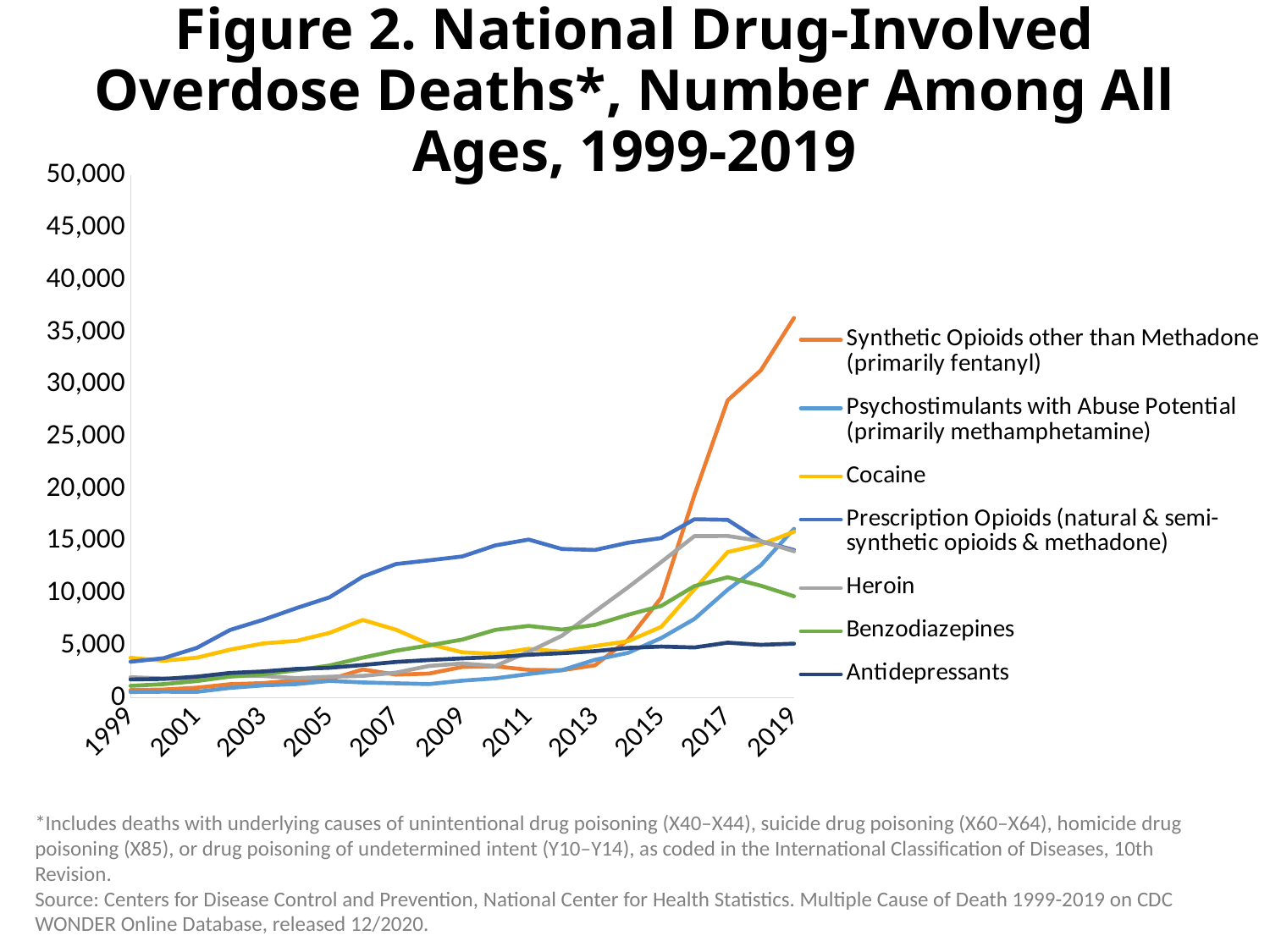
Is the value for Antidepressants in 2019 greater or less than 10,000? less In 2019, which is larger: Synthetic Opioids other than Methadone or Heroin? Synthetic Opioids other than Methadone How many series does the legend list? 7 Does the Synthetic Opioids other than Methadone line rise or fall from 2013 to 2019? rise Which series has the lowest value in 2019? Antidepressants What is the title of the chart? Figure 2. National Drug-Involved Overdose Deaths*, Number Among All Ages, 1999-2019 Is the value for Synthetic Opioids other than Methadone in 2019 greater or less than 30,000? greater Which series has the highest value in 2019? Synthetic Opioids other than Methadone (primarily fentanyl) Is the value for Prescription Opioids in 2017 greater or less than 15,000? greater How many year labels are shown along the x axis? 11 What kind of chart is shown on the slide? line chart